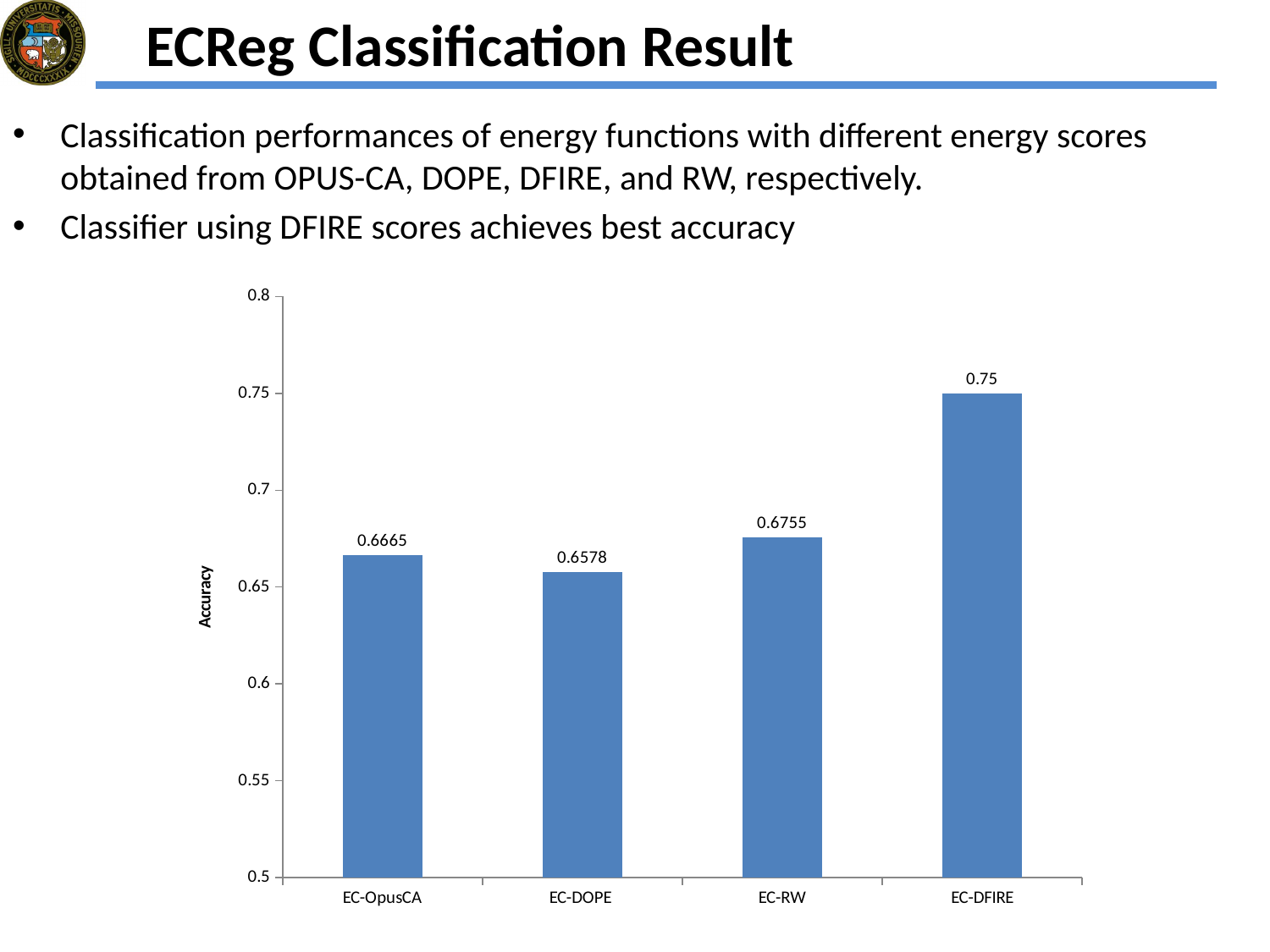
What kind of chart is shown on the slide? bar chart How many categories are shown on the x axis of the chart? 4 Which category has the lowest accuracy? EC-DOPE What is the accuracy for EC-DFIRE? 0.75 Is the accuracy for EC-DOPE greater or less than 0.7? less What is the accuracy for EC-RW? 0.6755 What is the difference in accuracy between EC-OpusCA and EC-DOPE? 0.0087 Which has a higher accuracy, EC-RW or EC-OpusCA? EC-RW Which category has the highest accuracy? EC-DFIRE What is the difference in accuracy between EC-DFIRE and EC-RW? 0.0745 What is the accuracy for EC-OpusCA? 0.6665 What is the accuracy for EC-DOPE? 0.6578